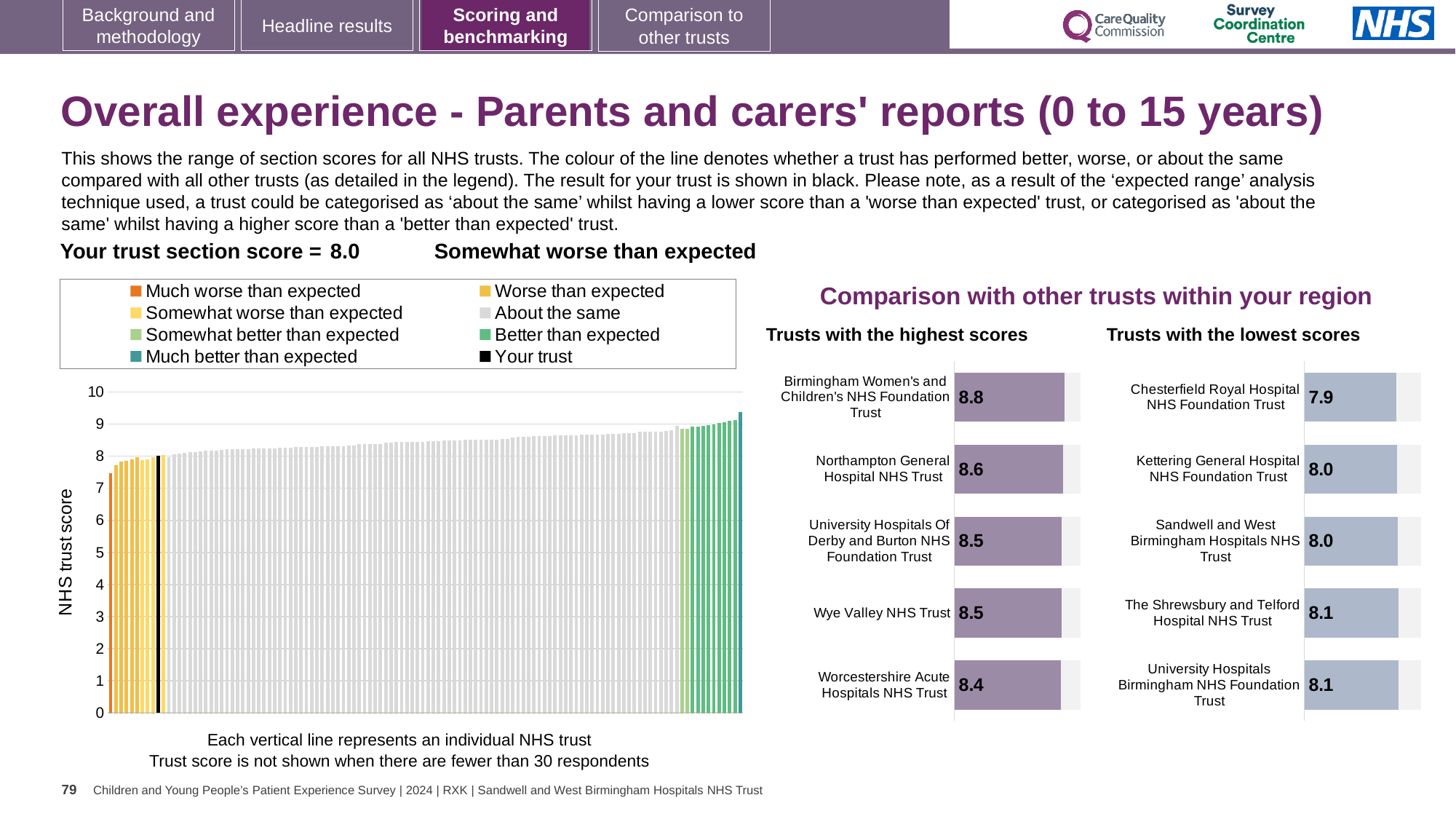
In the large chart on the left, do the trust scores rise or fall from left to right? Rise In the 'Trusts with the highest scores' chart, which trust has the highest score? Birmingham Women's and Children's NHS Foundation Trust In the 'Trusts with the lowest scores' chart, which has the larger score: Chesterfield Royal Hospital NHS Foundation Trust or The Shrewsbury and Telford Hospital NHS Trust? The Shrewsbury and Telford Hospital NHS Trust In the 'Trusts with the highest scores' chart, what is the score for Birmingham Women's and Children's NHS Foundation Trust? 8.8 In the 'Trusts with the highest scores' chart, how many trusts are shown? 5 How many entries does the legend of the large chart on the left list? 8 In the 'Trusts with the highest scores' chart, what is the difference between the scores of Birmingham Women's and Children's NHS Foundation Trust and Worcestershire Acute Hospitals NHS Trust? 0.4 What kind of chart is the large chart on the left showing NHS trust scores? Bar chart In the 'Trusts with the highest scores' chart, what is the score for Worcestershire Acute Hospitals NHS Trust? 8.4 In the 'Trusts with the lowest scores' chart, what is the score for Chesterfield Royal Hospital NHS Foundation Trust? 7.9 In the 'Trusts with the lowest scores' chart, what is the difference between the scores of The Shrewsbury and Telford Hospital NHS Trust and Chesterfield Royal Hospital NHS Foundation Trust? 0.2 In the 'Trusts with the lowest scores' chart, which trust has the lowest score? Chesterfield Royal Hospital NHS Foundation Trust